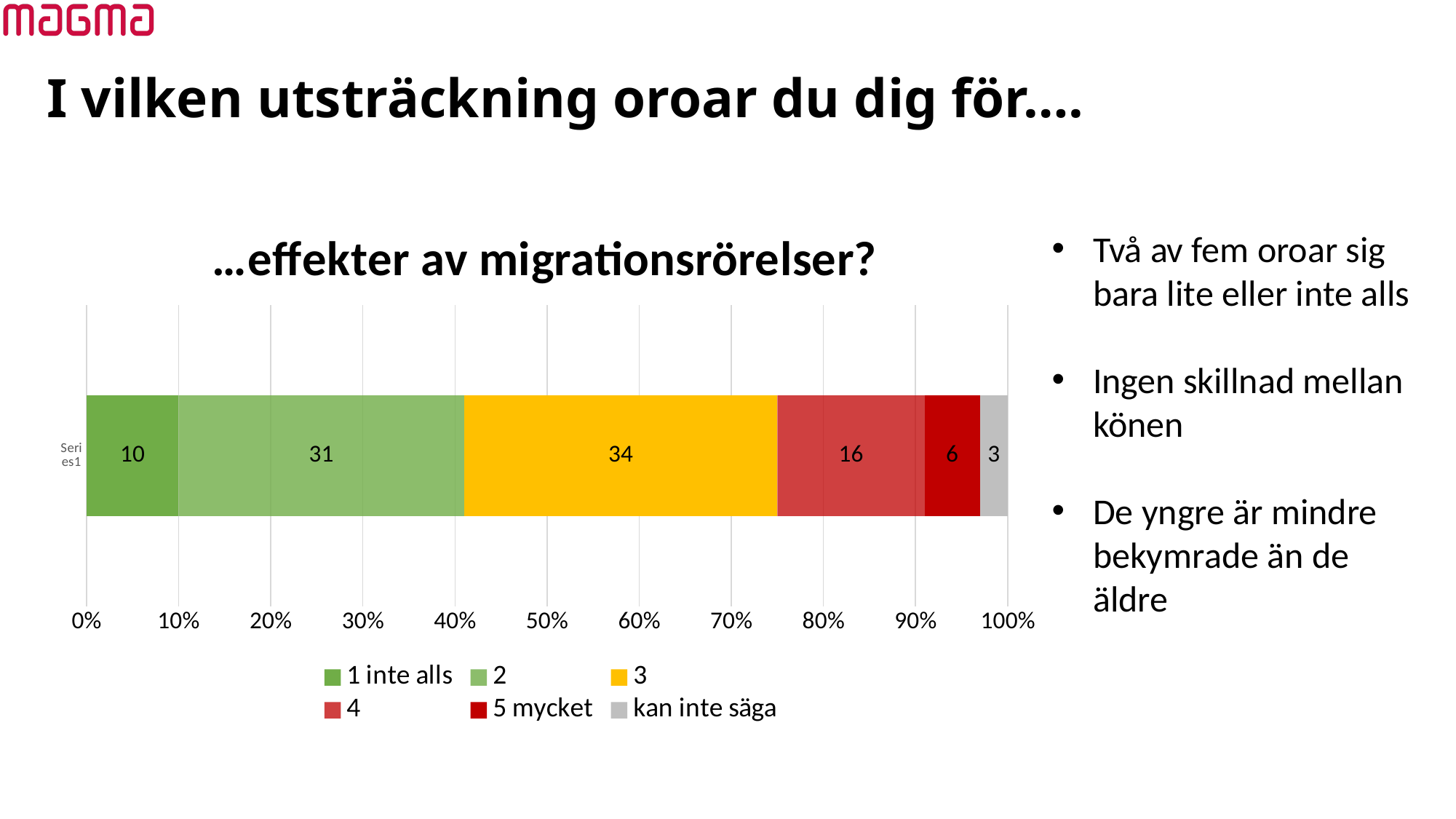
What is the title of the chart? …effekter av migrationsrörelser? Which is larger, the value for "4" or the value for "5 mycket"? 4 How many series does the legend list? 6 What is the value for the "5 mycket" series? 6 What is the value for the "kan inte säga" series? 3 What is the value for the "3" series in the stacked bar? 34 What is the value for the "1 inte alls" series? 10 Which series has the largest value in the bar? 3 Which series has the smallest value in the bar? kan inte säga What is the total of the values shown in the stacked bar? 100 What kind of chart is shown on the slide? Stacked bar chart What is the difference between the values for series "2" and series "4"? 15